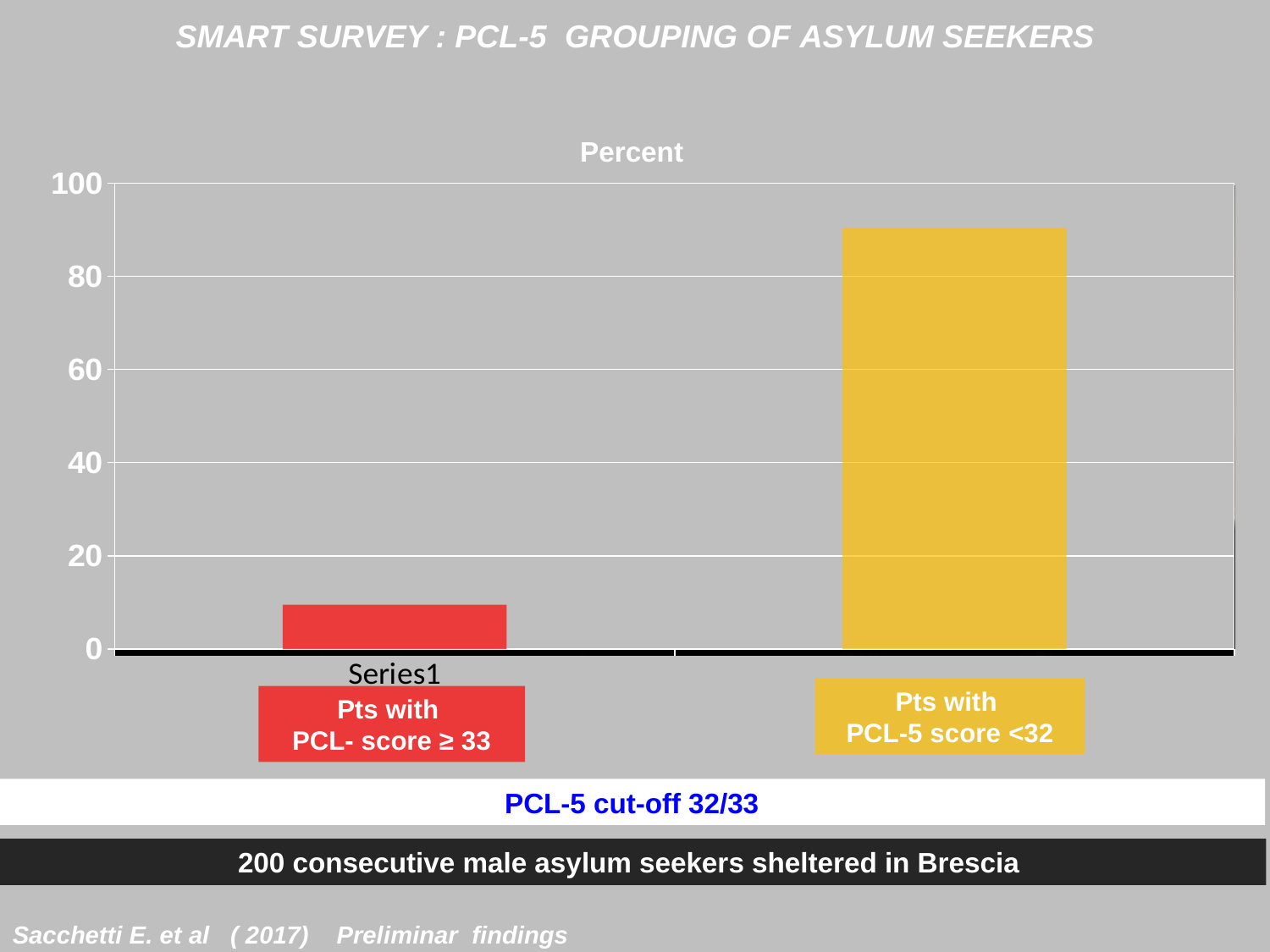
What kind of chart is shown on the slide? bar chart Which group has the lowest bar in the chart? Pts with PCL- score ≥ 33 Is the value for patients with PCL- score ≥ 33 greater or less than 40? less How many bars are plotted in the chart? 2 What colour is the bar for patients with PCL-5 score <32? yellow Is the value for patients with PCL-5 score <32 greater or less than 100? less Is the bar for patients with PCL-5 score <32 larger or smaller than the bar for patients with PCL- score ≥ 33? larger What is the highest value shown on the vertical axis? 100 What is the title shown above the chart's plot area? Percent Is the value for patients with PCL-5 score <32 greater or less than 80? greater Which group has the higher bar, patients with PCL-5 score ≥ 33 or patients with PCL-5 score <32? Pts with PCL-5 score <32